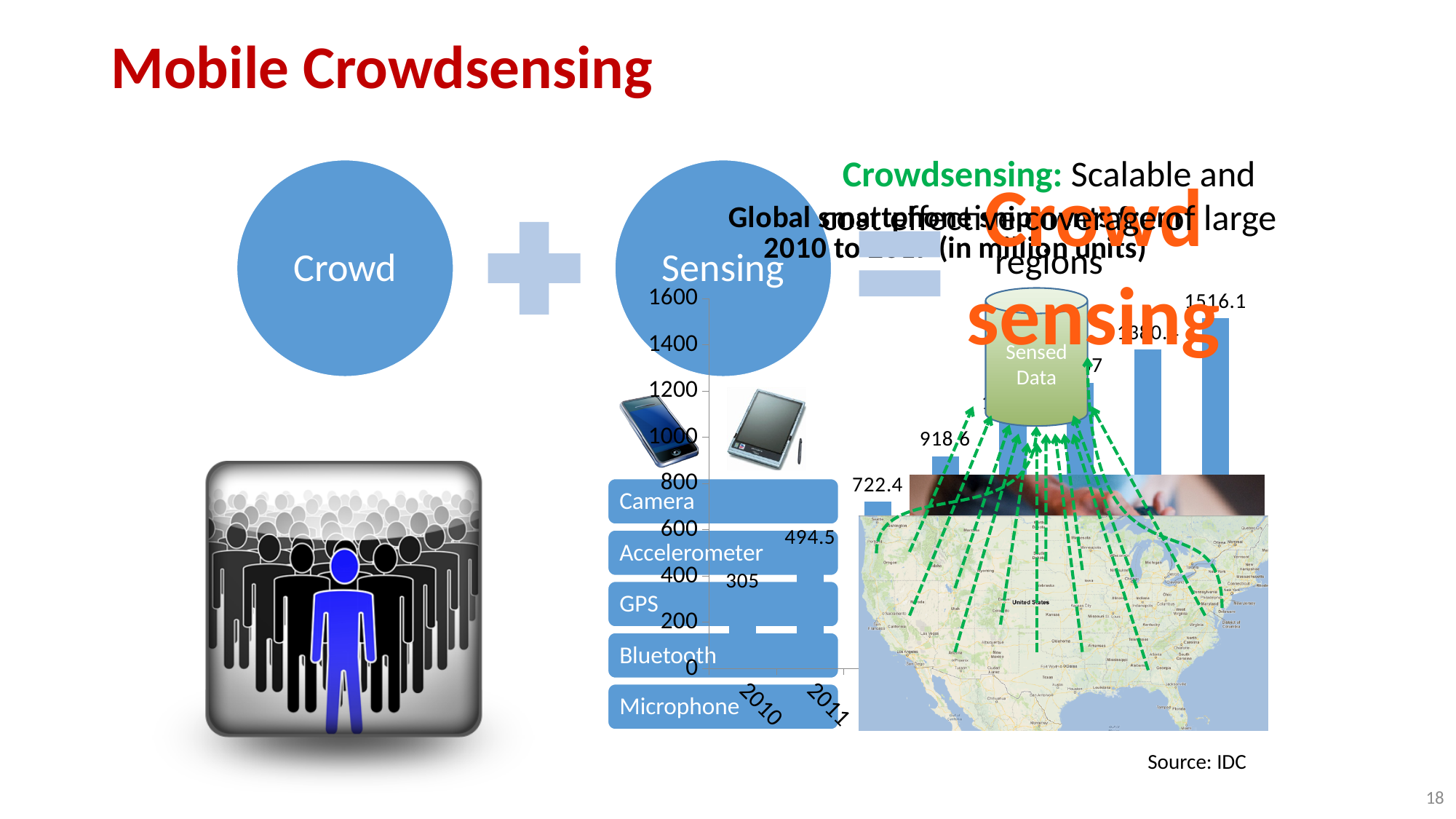
Is the value for 2010 in the smartphone shipments chart greater or less than 400? less Do the values in the smartphone shipments chart rise or fall from left to right along the x axis? Rise Which year has the larger value in the smartphone shipments chart, 2010 or 2011? 2011 Is the value for 2011 in the smartphone shipments chart greater or less than 400? greater What is the data label on the tallest bar in the smartphone shipments chart? 1516.1 What is the value for 2011 in the global smartphone shipments chart? 494.5 What kind of chart is used to show global smartphone shipments? Bar chart What is the highest tick value shown on the y axis of the smartphone shipments chart? 1600 What is the value for 2010 in the global smartphone shipments chart? 305 Which year has the lowest bar in the smartphone shipments chart? 2010 What source is cited for the smartphone shipments chart? IDC By how much does the 2011 value exceed the 2010 value in the smartphone shipments chart? 189.5